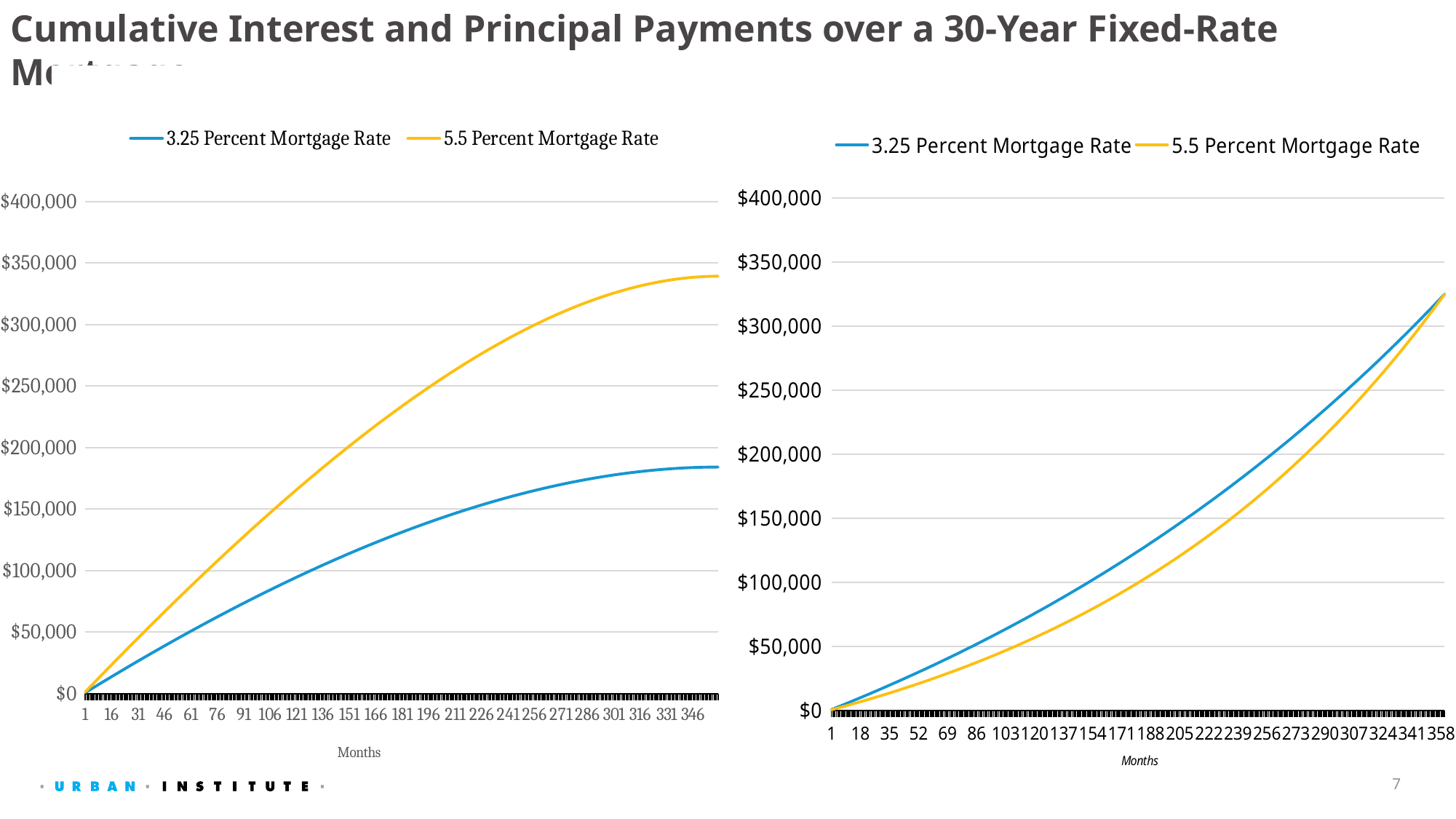
In the left chart, which series reaches the higher value at the end of the 30-year period? 5.5 Percent Mortgage Rate In the left chart, is the final value of the 5.5 Percent Mortgage Rate line greater or less than $300,000? greater How many series does the legend of the right chart list? 2 In the right chart, is the final value of the 3.25 Percent Mortgage Rate line greater or less than $300,000? greater In the right chart, do the values rise or fall as the months increase? Rise What kind of chart is the right chart on the slide? Line chart What is the x-axis label on the left chart? Months In the left chart, is the final value of the 3.25 Percent Mortgage Rate line greater or less than $200,000? less In the right chart, at month 188, which series has the higher value? 3.25 Percent Mortgage Rate What kind of chart is the left chart on the slide? Line chart How many series does the legend of the left chart list? 2